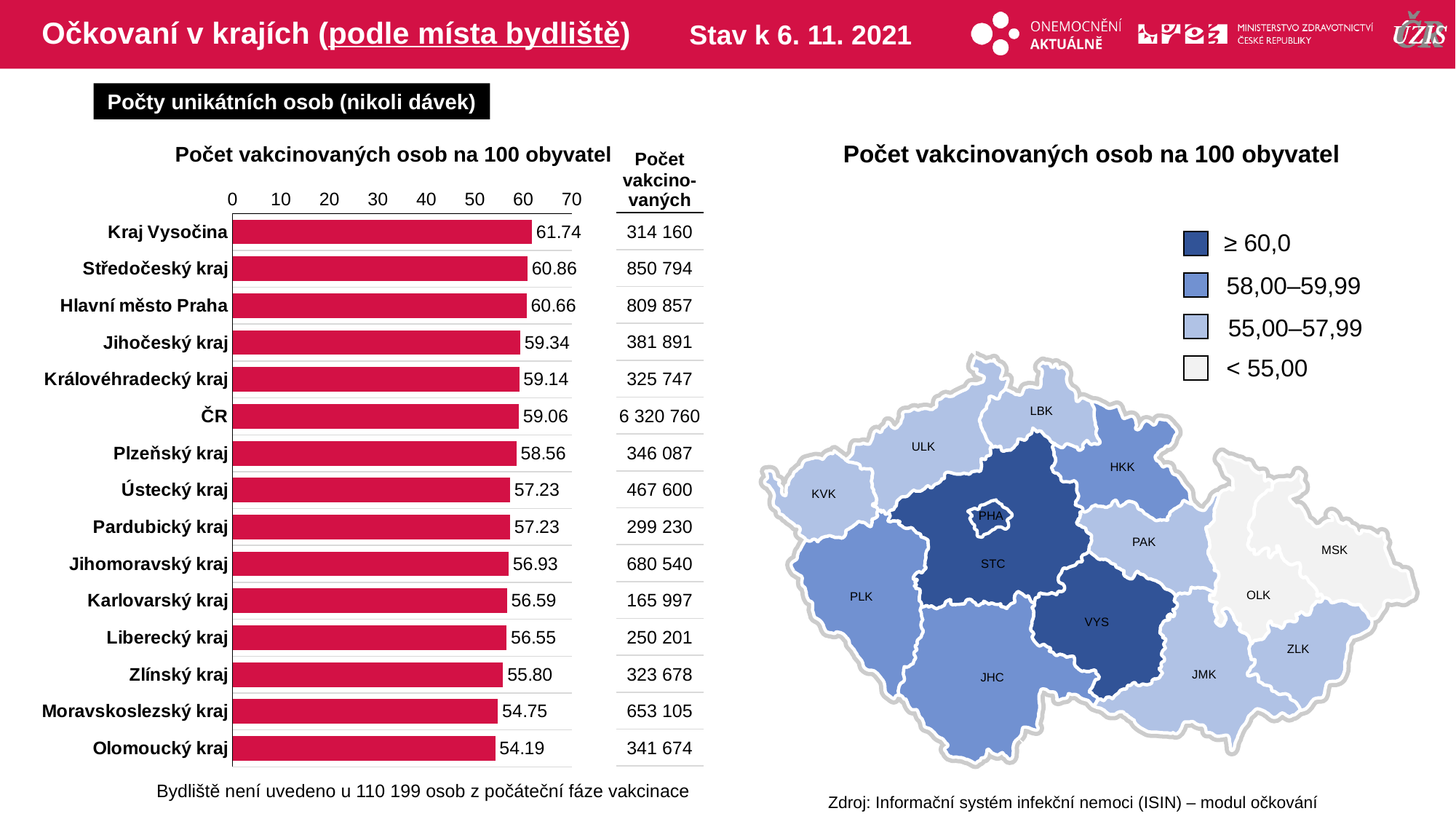
In the bar chart, which category has the lowest value? Olomoucký kraj In the bar chart, which category has the highest value? Kraj Vysočina In the bar chart, what is the value for Kraj Vysočina? 61.74 In the bar chart, what is the value for ČR? 59.06 In the bar chart, what is the difference between the values for Kraj Vysočina and Olomoucký kraj? 7.55 In the bar chart, is the value for Moravskoslezský kraj greater or less than 60? less How many categories (bars) does the bar chart show? 15 What is the title of the bar chart on the left? Počet vakcinovaných osob na 100 obyvatel What kind of chart is shown on the left of the slide? bar chart In the bar chart, what is the difference between the values for Kraj Vysočina and ČR? 2.68 In the bar chart, what is the value for Olomoucký kraj? 54.19 In the bar chart, which has the larger value, Jihočeský kraj or Plzeňský kraj? Jihočeský kraj